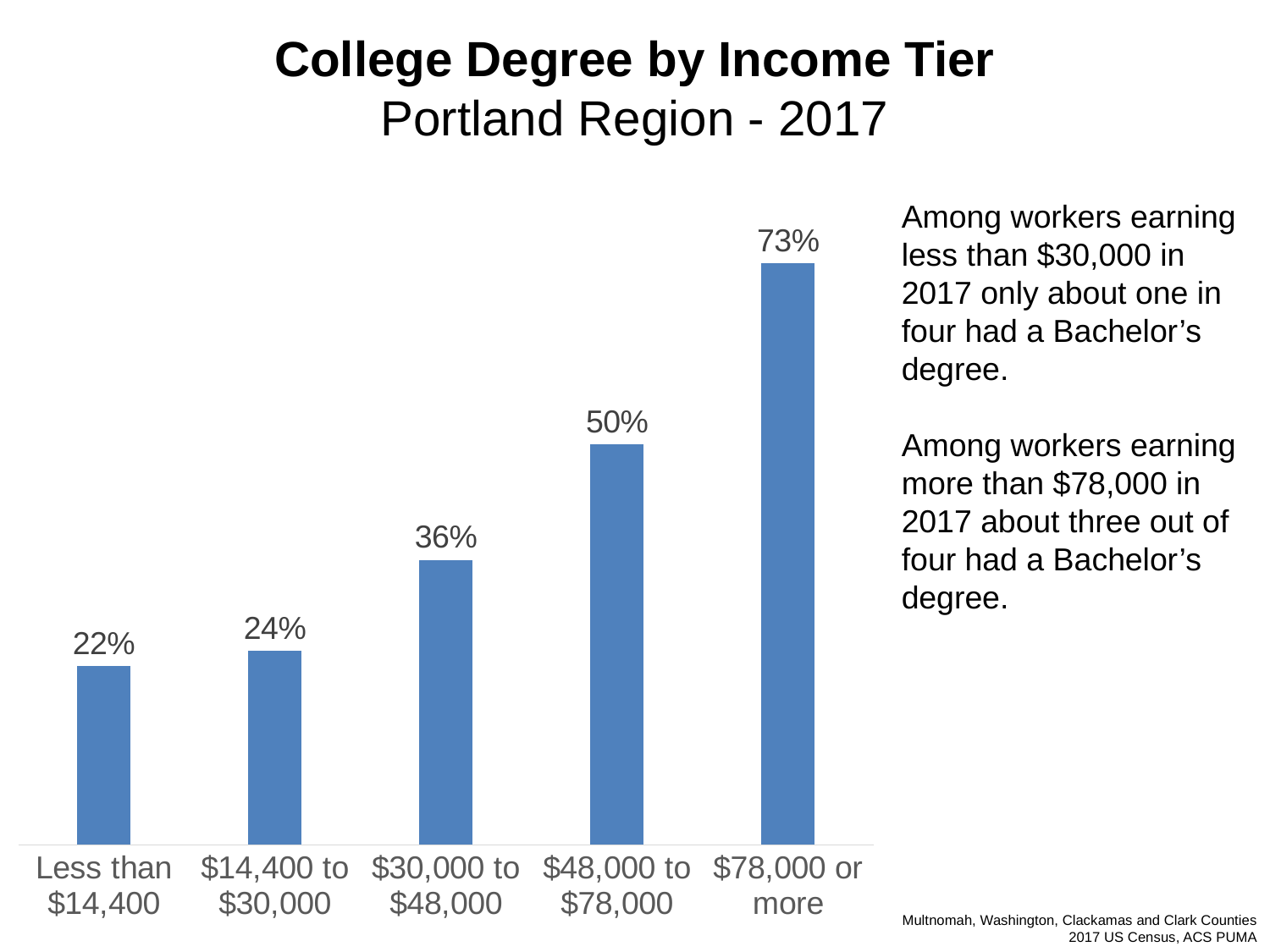
What percentage of workers earning less than $14,400 had a college degree? 22% What is the difference between the $78,000 or more tier and the $48,000 to $78,000 tier? 23 percentage points What is the title of the chart? College Degree by Income Tier, Portland Region - 2017 Which income tier has the lowest share with a college degree? Less than $14,400 What kind of chart is shown on the slide? Bar chart What is the difference between the $14,400 to $30,000 tier and the Less than $14,400 tier? 2 percentage points Do the values rise or fall as income tier increases along the x axis? Rise Which income tier has the highest share with a college degree? $78,000 or more What is the value for the $30,000 to $48,000 income tier? 36% Which is larger, the value for $30,000 to $48,000 or the value for $48,000 to $78,000? $48,000 to $78,000 How many income tiers are shown in the chart? 5 What is the value for the $48,000 to $78,000 income tier? 50%